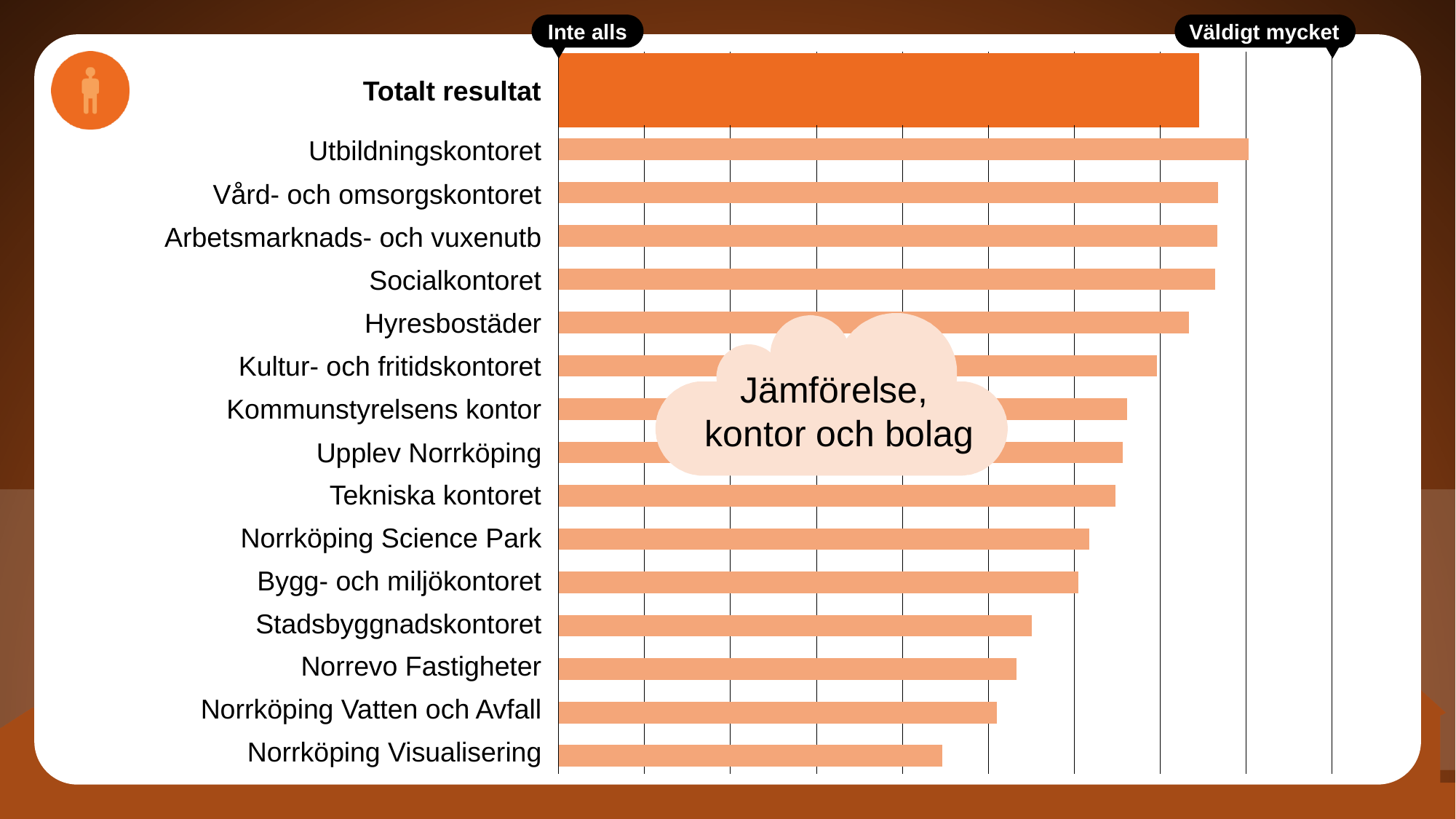
Which office or company has the longest bar in the chart? Utbildningskontoret Do the bars for the offices and companies get longer or shorter going from top to bottom of the chart? Shorter How many offices and companies are listed below the 'Totalt resultat' bar? 15 Which bar is longer: Utbildningskontoret or Totalt resultat? Utbildningskontoret Which office or company has the shortest bar in the chart? Norrköping Visualisering Which bar is longer: Norrköping Science Park or Norrköping Visualisering? Norrköping Science Park Which bar is longer: Socialkontoret or Kultur- och fritidskontoret? Socialkontoret What label marks the right end of the chart's scale? Väldigt mycket What label marks the left end of the chart's scale? Inte alls What kind of chart is shown on the slide? Bar chart